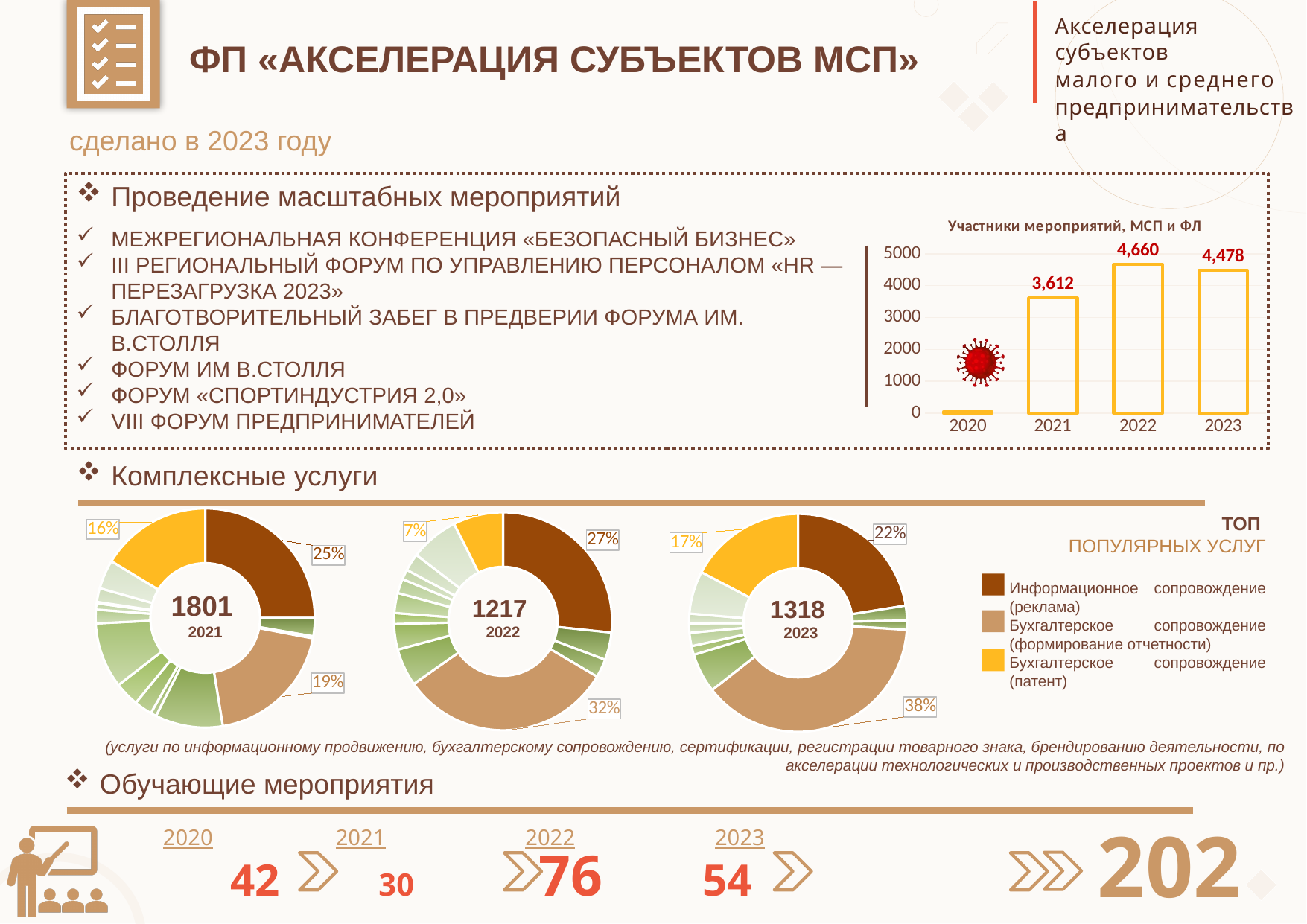
In the bar chart 'Участники мероприятий, МСП и ФЛ', which year has the lowest value? 2020 In the bar chart 'Участники мероприятий, МСП и ФЛ', is the value for 2021 greater or less than 3000? greater In the bar chart 'Участники мероприятий, МСП и ФЛ', what is the difference between the values for 2022 and 2023? 182 In the 2021 donut chart under 'Комплексные услуги', what share is labelled for 'Информационное сопровождение (реклама)'? 25% How many years are shown on the x axis of the bar chart 'Участники мероприятий, МСП и ФЛ'? 4 In the bar chart 'Участники мероприятий, МСП и ФЛ', which year has the highest value? 2022 What total number is shown in the centre of the 2022 donut chart under 'Комплексные услуги'? 1217 How many entries does the legend next to the donut charts under 'Комплексные услуги' list? 3 In the bar chart 'Участники мероприятий, МСП и ФЛ', what is the value for 2022? 4,660 What kind of chart is 'Участники мероприятий, МСП и ФЛ'? bar chart In the bar chart 'Участники мероприятий, МСП и ФЛ', what is the value for 2021? 3,612 In the 2023 donut chart under 'Комплексные услуги', what share is labelled for 'Бухгалтерское сопровождение (формирование отчетности)'? 38%